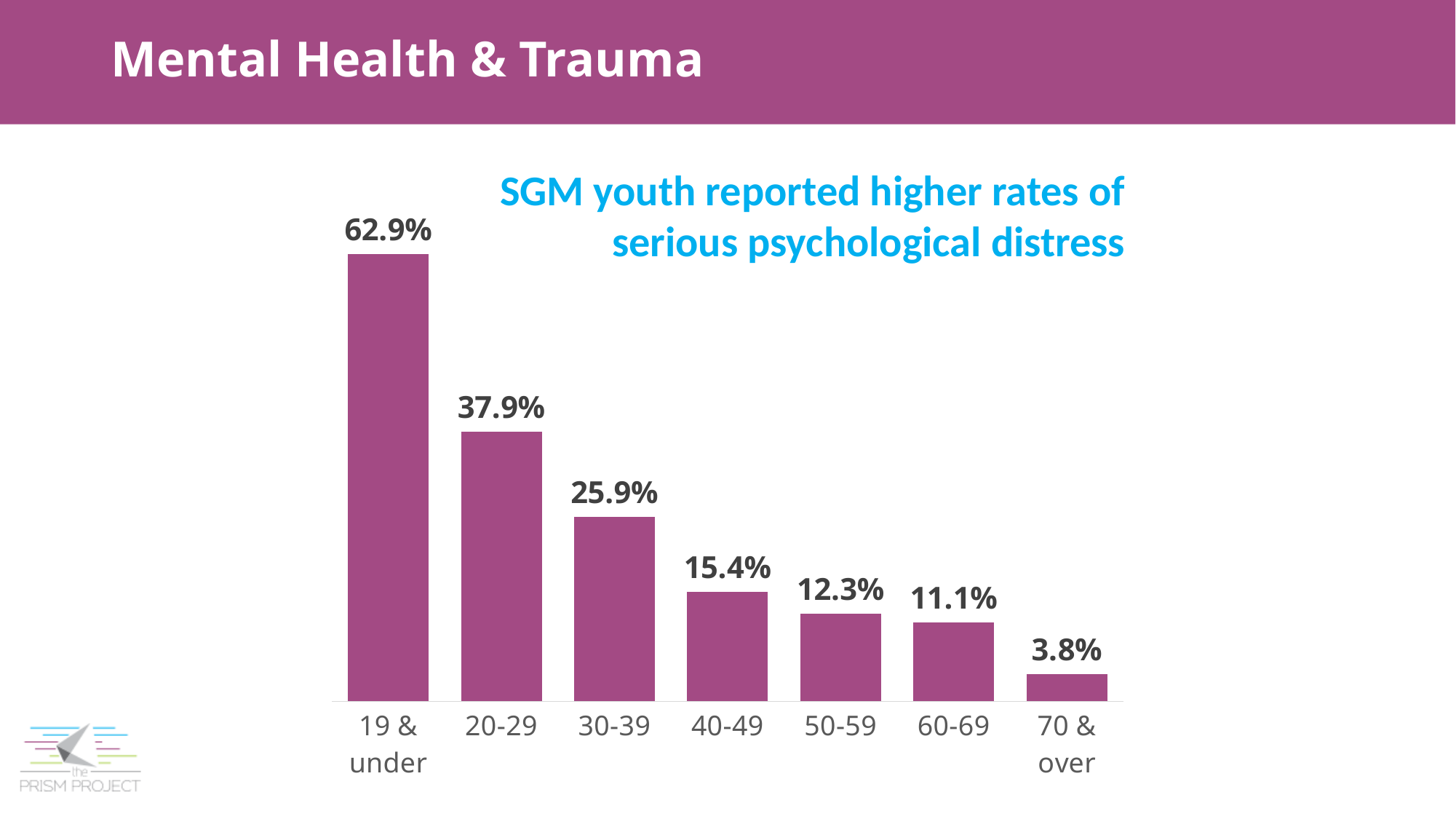
Which age group has the lowest value? 70 & over What is the value for the 19 & under age group? 62.9% What kind of chart is shown on the slide? Bar chart Do the values rise or fall as age increases along the x axis? Fall What is the value for the 40-49 age group? 15.4% How many age groups are shown on the chart? 7 What is the difference between the values for 19 & under and 20-29? 25.0% What is the value for the 70 & over age group? 3.8% What is the title of the chart? SGM youth reported higher rates of serious psychological distress Which age group has the highest value? 19 & under Which is larger, the value for 30-39 or the value for 40-49? 30-39 What is the difference between the values for 50-59 and 60-69? 1.2%